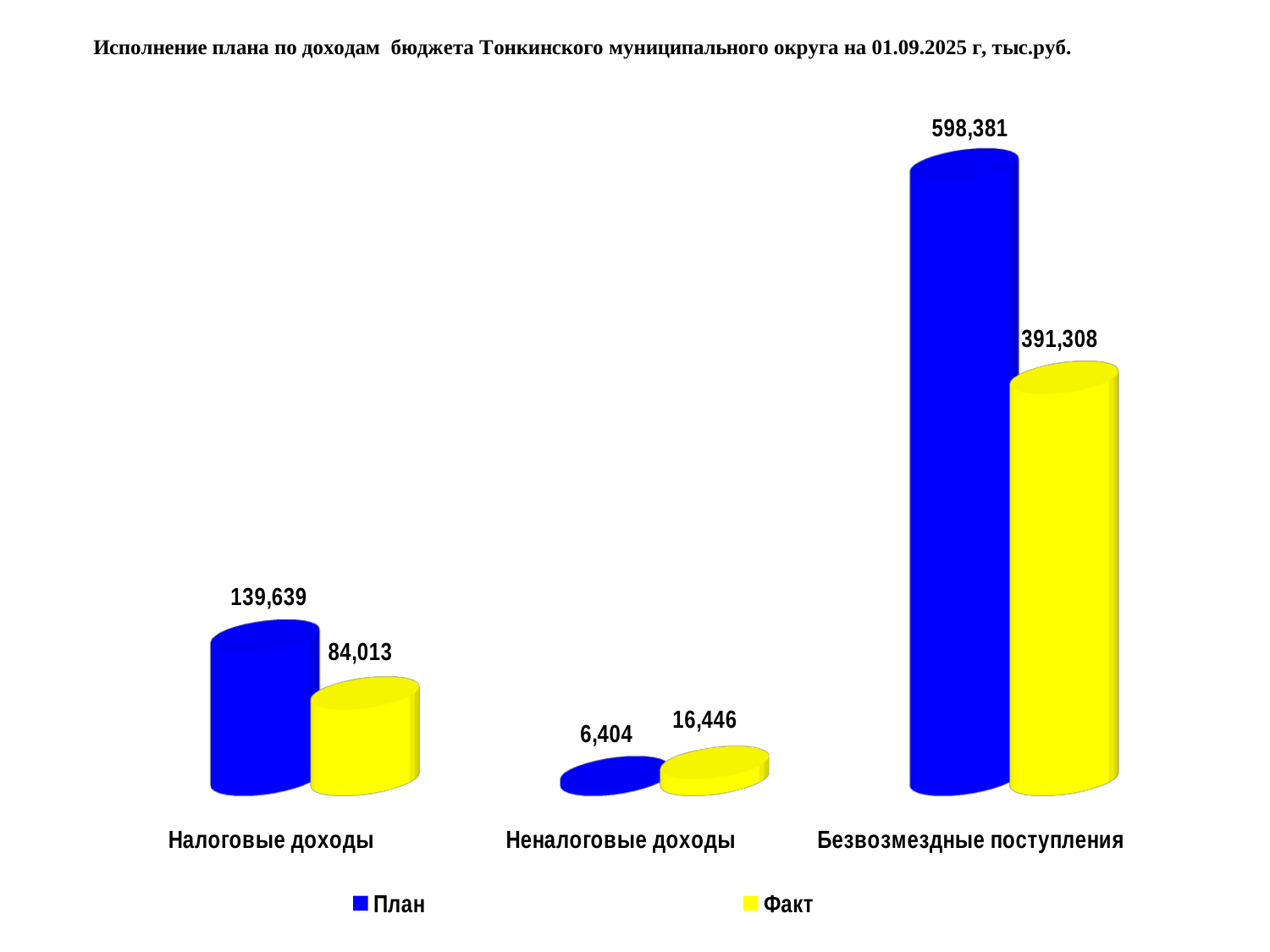
What is the План value for Налоговые доходы? 139,639 What is the Факт value for Неналоговые доходы? 16,446 How many series does the legend list? 2 For Неналоговые доходы, which is larger: План or Факт? Факт What kind of chart is shown on the slide? Bar chart What is the Факт value for Безвозмездные поступления? 391,308 Which category has the lowest Факт value? Неналоговые доходы What is the difference between План and Факт for Безвозмездные поступления? 207,073 What is the difference between План and Факт for Налоговые доходы? 55,626 Which category has the highest План value? Безвозмездные поступления What is the План value for Неналоговые доходы? 6,404 How many categories are shown on the x axis? 3